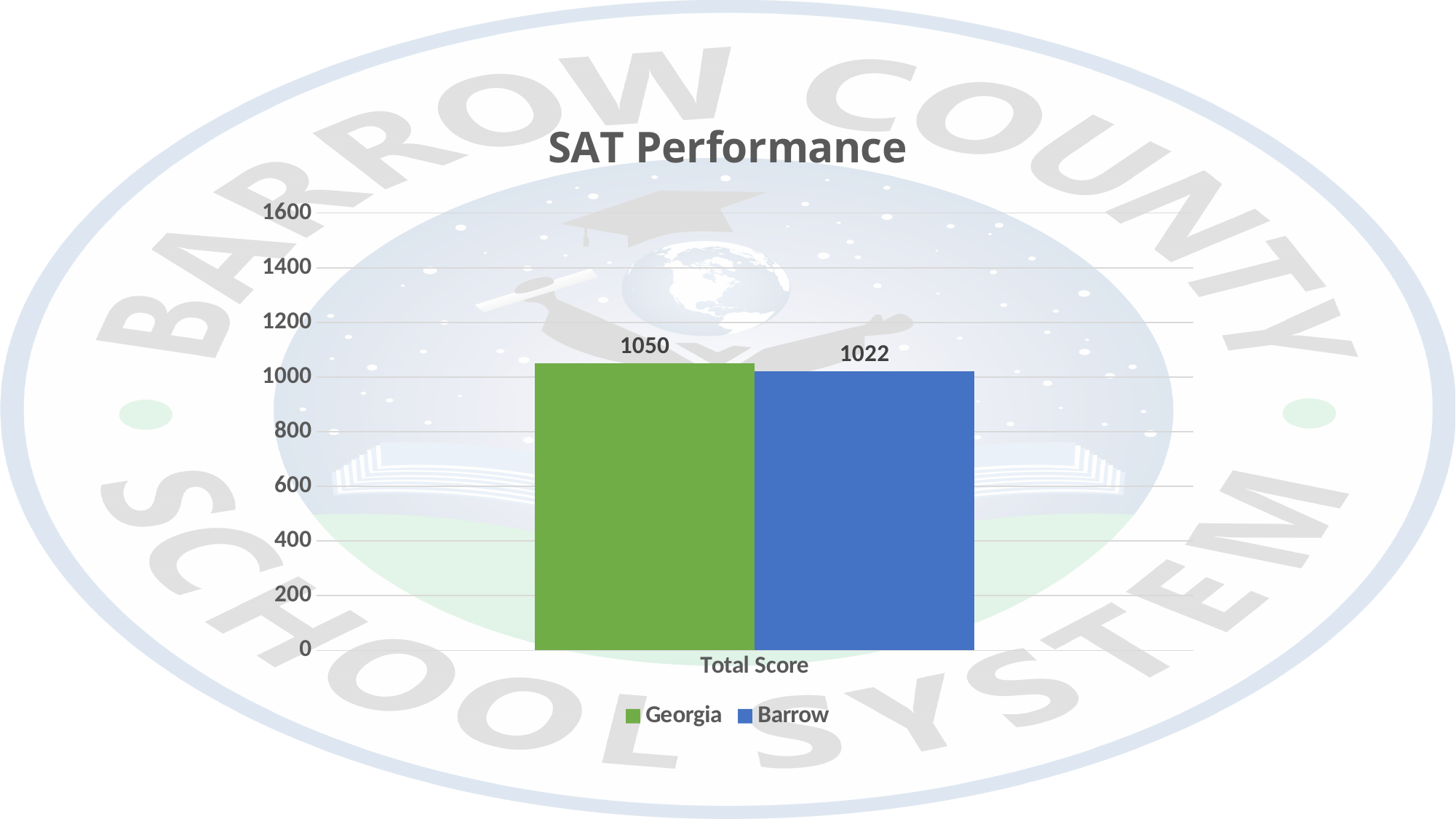
How many categories are shown on the x axis? 1 What colour is the bar for Barrow? Blue What is the SAT total score for Barrow? 1022 Which series has the higher total score, Georgia or Barrow? Georgia What is the SAT total score for Georgia? 1050 Is the value for Georgia greater or less than 1200? less How many series does the legend list? 2 Is the value for Barrow greater or less than 1000? greater What kind of chart is shown on the slide? Bar chart What is the title of the chart? SAT Performance What is the difference between the Georgia and Barrow total scores? 28 Which series has the lowest total score? Barrow